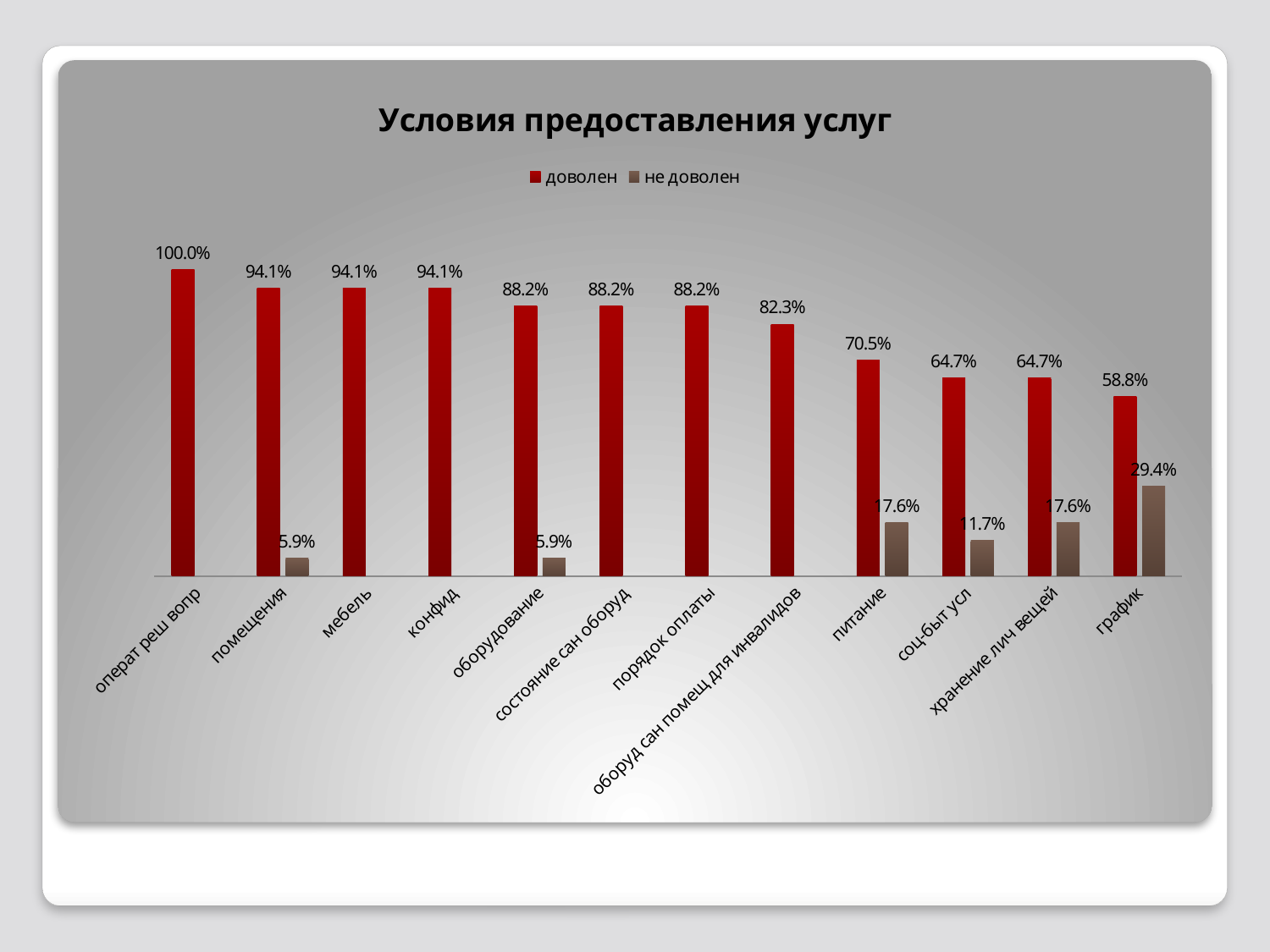
How many series does the legend list? 2 What type of chart is shown on the slide? bar chart What is the value of "доволен" for "операт реш вопр"? 100.0% Which category has the lowest "доволен" value? график What is the value of "доволен" for "питание"? 70.5% Do the "доволен" values rise or fall from left to right along the x axis? fall What is the value of "не доволен" for "график"? 29.4% What is the title of the chart? Условия предоставления услуг How many categories are shown on the x axis? 12 Which category has the highest "не доволен" value? график What is the difference between the "доволен" values for "оборуд сан помещ для инвалидов" and "соц-быт усл"? 17.6% Which is larger: the "не доволен" value for "питание" or for "соц-быт усл"? питание